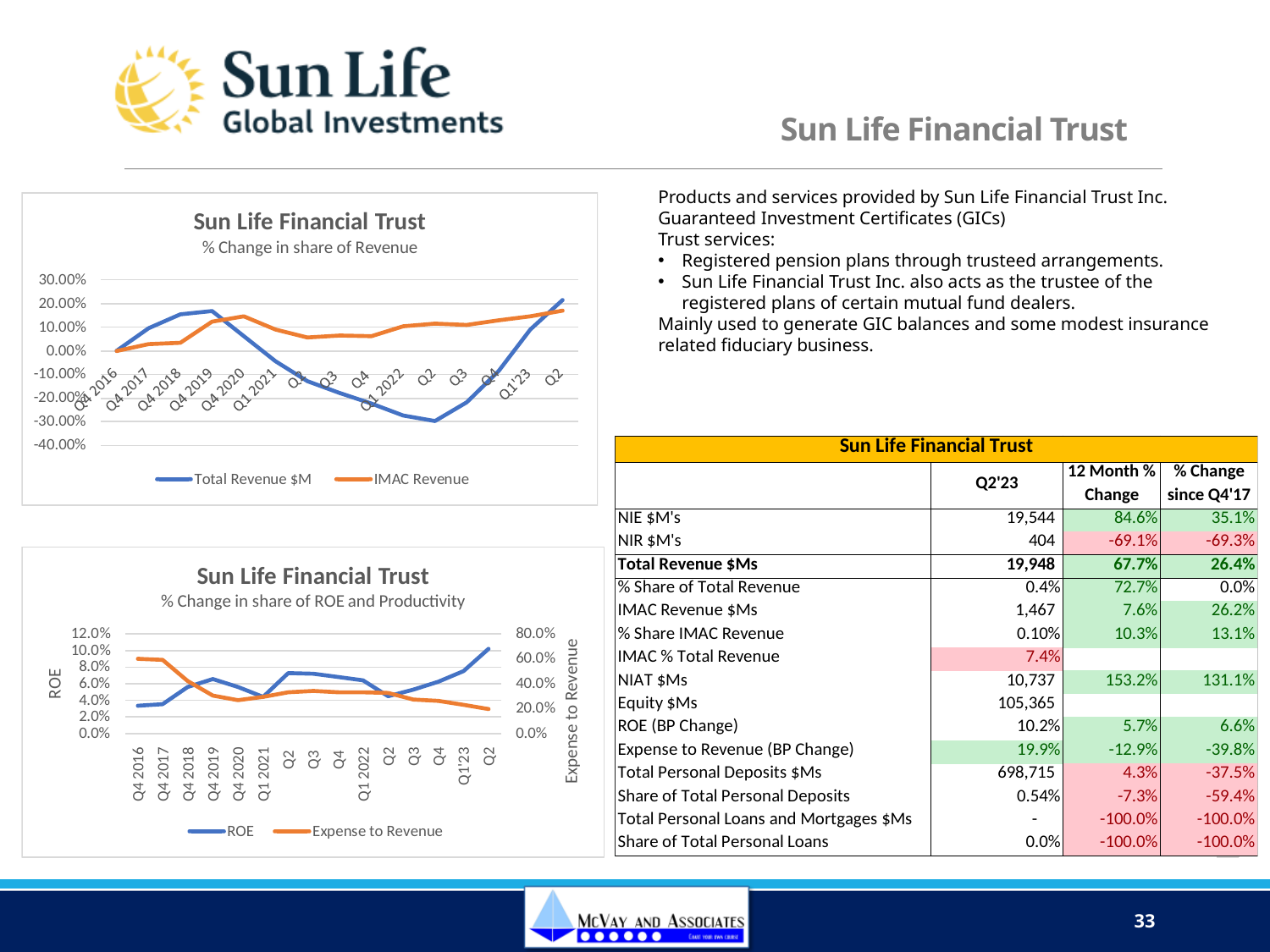
In the top chart (% Change in share of Revenue), is the value for Total Revenue $M at Q2 2022 greater or less than -20.00%? less What are the two series named in the legend of the bottom chart (% Change in share of ROE and Productivity)? ROE and Expense to Revenue What type of chart is the top chart titled 'Sun Life Financial Trust % Change in share of Revenue'? Line chart In the top chart (% Change in share of Revenue), which series has the higher value at Q2 2022, Total Revenue $M or IMAC Revenue? IMAC Revenue In the bottom chart (% Change in share of ROE and Productivity), is the ROE value at the final point (Q2) greater or less than 8.0%? greater How many series does the legend of the top chart (% Change in share of Revenue) list? 2 In the bottom chart (% Change in share of ROE and Productivity), does the Expense to Revenue series generally rise or fall from Q4 2016 to Q2? Fall In the bottom chart (% Change in share of ROE and Productivity), is the Expense to Revenue value at Q4 2016 greater or less than 40.0%? greater What is the label of the right-hand vertical axis in the bottom chart (% Change in share of ROE and Productivity)? Expense to Revenue How many x-axis categories are plotted in the top chart (% Change in share of Revenue)? 15